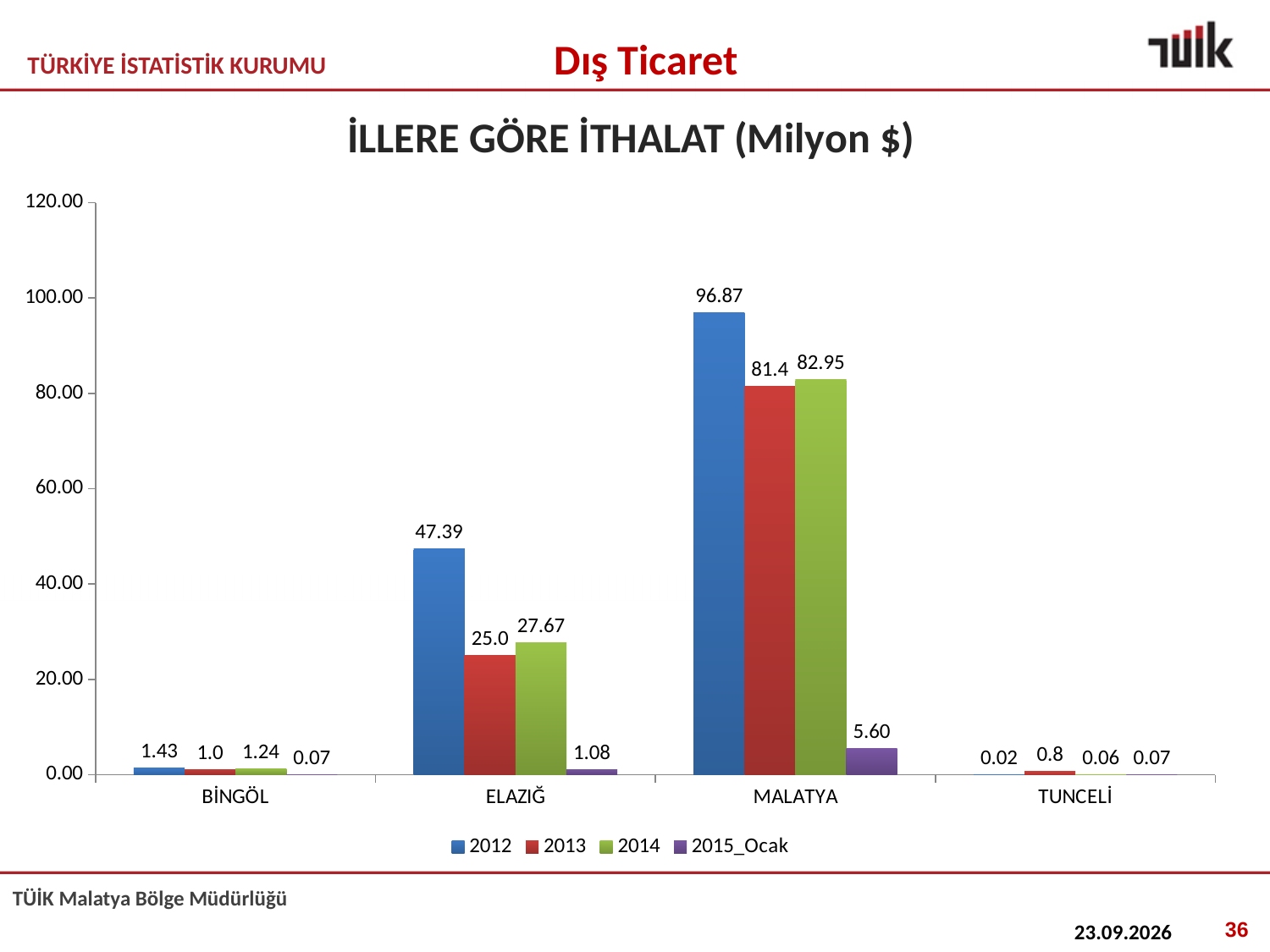
What type of chart is shown on the slide? bar chart Which province has the highest 2012 import value? MALATYA What is the 2015_Ocak value for MALATYA? 5.60 What is the difference between the 2012 and 2013 values for ELAZIĞ? 22.39 How many provinces are shown on the x axis? 4 What is the 2012 import value for MALATYA? 96.87 Which is larger for MALATYA: the 2013 value or the 2014 value? 2014 What is the 2014 import value for ELAZIĞ? 27.67 What is the title of the chart? İLLERE GÖRE İTHALAT (Milyon $) What is the 2013 value for TUNCELİ? 0.8 Which province has the lowest 2014 import value? TUNCELİ How many series does the legend list? 4